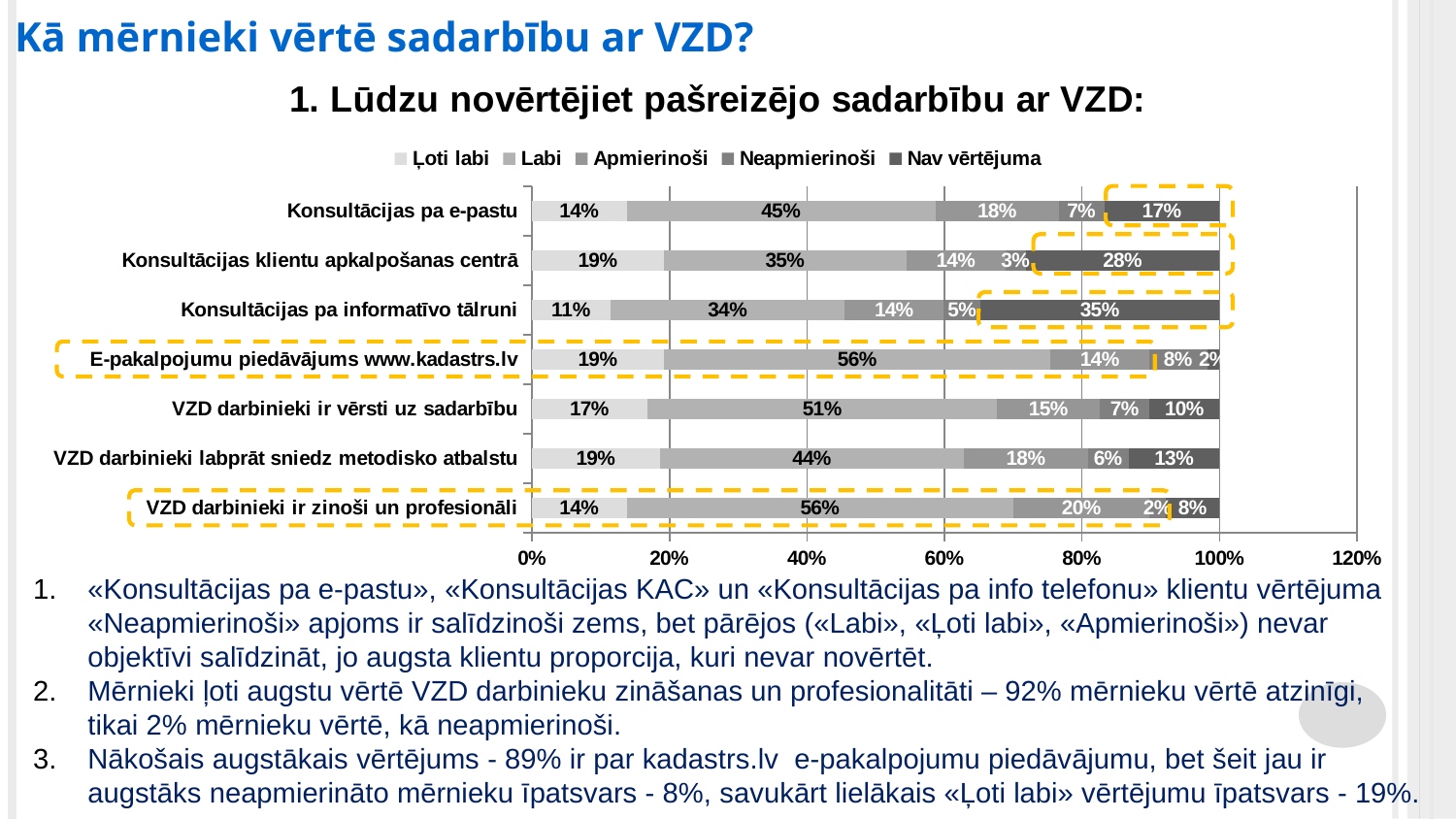
What type of chart is shown on the slide? Stacked bar chart Which category has the lowest "Ļoti labi" value? Konsultācijas pa informatīvo tālruni Which is larger: the "Apmierinoši" value for "VZD darbinieki ir zinoši un profesionāli" or for "Konsultācijas klientu apkalpošanas centrā"? VZD darbinieki ir zinoši un profesionāli What is the difference between the "Labi" value for "E-pakalpojumu piedāvājums www.kadastrs.lv" and the "Labi" value for "Konsultācijas pa e-pastu"? 11% What is the "Nav vērtējuma" value for "Konsultācijas pa informatīvo tālruni"? 35% How many series does the legend list? 5 What is the total of all segments in the bar for "VZD darbinieki ir zinoši un profesionāli"? 100% What is the "Ļoti labi" value for "VZD darbinieki ir vērsti uz sadarbību"? 17% Which category has the highest "Nav vērtējuma" value? Konsultācijas pa informatīvo tālruni What is the "Labi" value for "Konsultācijas pa e-pastu"? 45% How many categories are plotted on the chart? 7 What is the "Neapmierinoši" value for "VZD darbinieki ir zinoši un profesionāli"? 2%